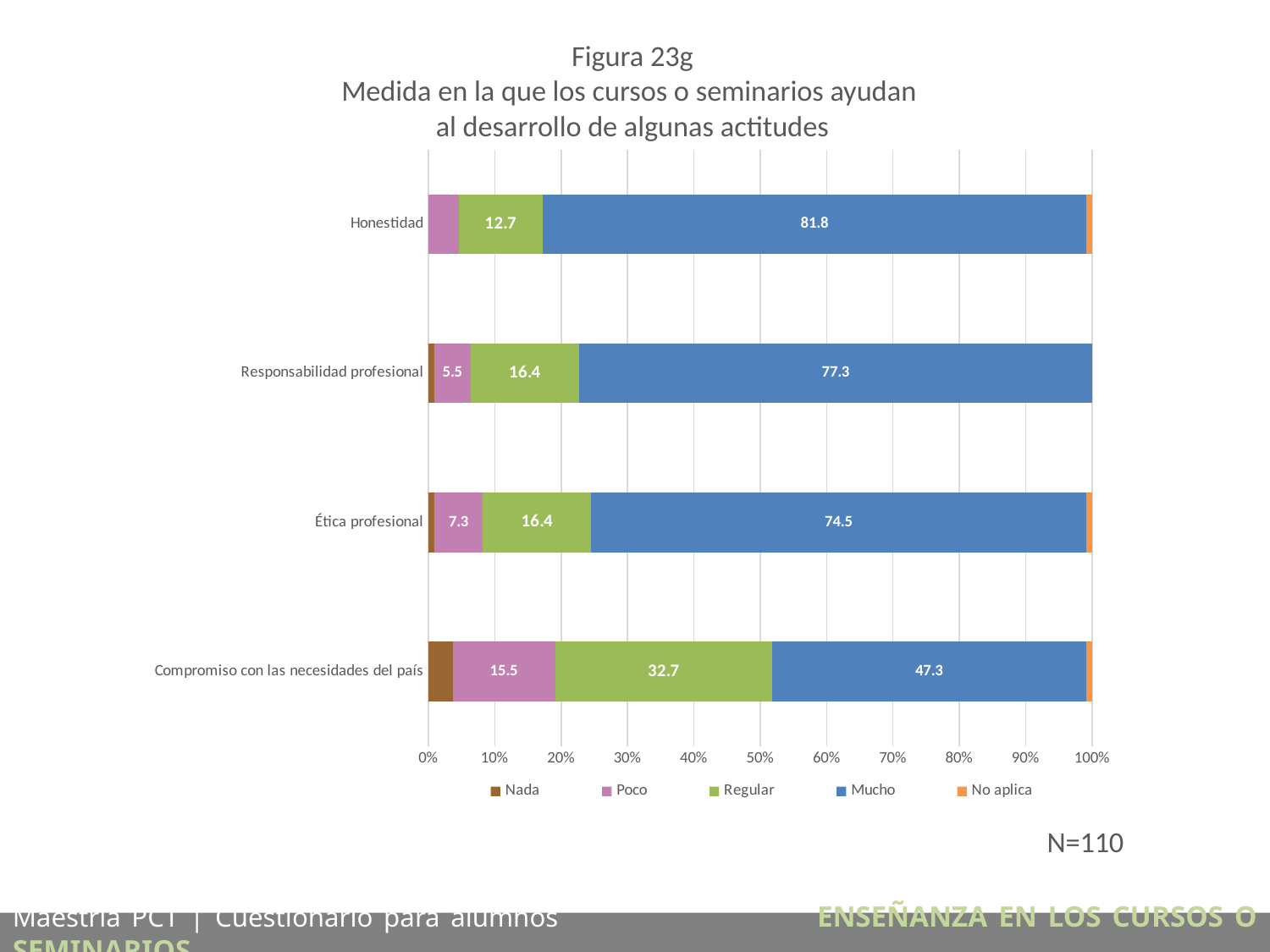
Which category has the highest Mucho value? Honestidad Is the Poco value for Honestidad greater or less than 10%? less Which is larger, the Poco value for Ética profesional or the Poco value for Responsabilidad profesional? Ética profesional Which category has the lowest Mucho value? Compromiso con las necesidades del país What is the value of the Mucho segment for Ética profesional? 74.5 How many series does the legend list? 5 What is the value of the Regular segment for Compromiso con las necesidades del país? 32.7 What is the value of the Poco segment for Responsabilidad profesional? 5.5 What kind of chart is shown on the slide? Stacked bar chart What is the difference between the Mucho values for Honestidad and Compromiso con las necesidades del país? 34.5 What is the value of the Mucho segment for Honestidad? 81.8 How many categories are shown on the chart? 4